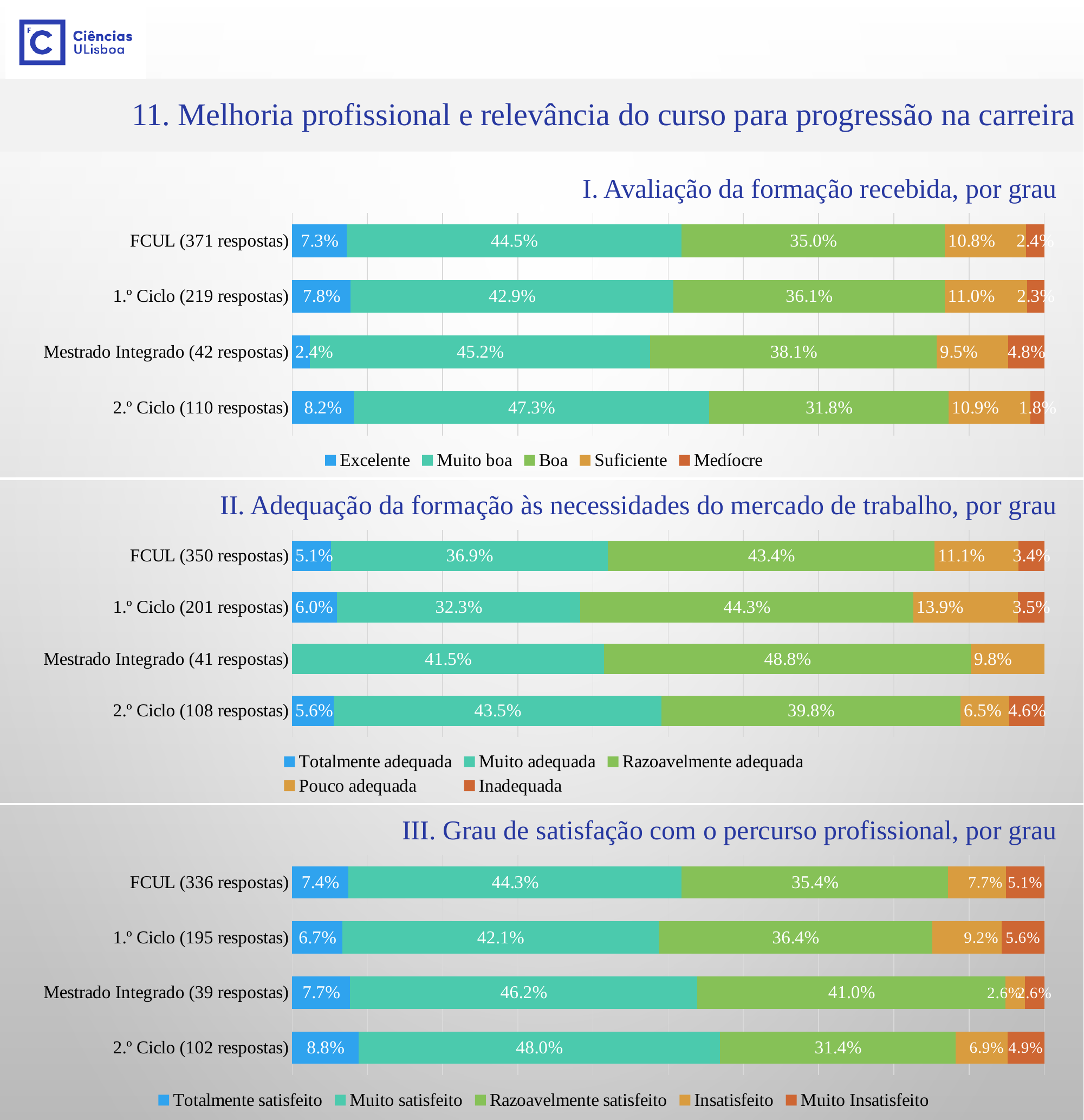
In chart III (Grau de satisfação com o percurso profissional, por grau), what is the difference between the 'Muito satisfeito' value for Mestrado Integrado (39 respostas) and for FCUL (336 respostas)? 1.9 percentage points In chart I (Avaliação da formação recebida, por grau), what is the difference between the 'Boa' value for FCUL (371 respostas) and for 2.º Ciclo (110 respostas)? 3.2 percentage points In chart III (Grau de satisfação com o percurso profissional, por grau), which category has the lowest 'Muito Insatisfeito' share? Mestrado Integrado (39 respostas) What kind of chart is chart III (Grau de satisfação com o percurso profissional, por grau)? Stacked bar chart In chart II (Adequação da formação às necessidades do mercado de trabalho, por grau), which has the larger 'Muito adequada' value: 1.º Ciclo (201 respostas) or 2.º Ciclo (108 respostas)? 2.º Ciclo (108 respostas) In chart III (Grau de satisfação com o percurso profissional, por grau), how many categories (bars) are shown? 4 In chart I (Avaliação da formação recebida, por grau), what is the 'Muito boa' value for 2.º Ciclo (110 respostas)? 47.3% In chart I (Avaliação da formação recebida, por grau), which category has the highest 'Excelente' share? 2.º Ciclo (110 respostas) In chart I (Avaliação da formação recebida, por grau), what is the 'Medíocre' value for Mestrado Integrado (42 respostas)? 4.8% In chart III (Grau de satisfação com o percurso profissional, por grau), what is the 'Totalmente satisfeito' value for 2.º Ciclo (102 respostas)? 8.8% In chart II (Adequação da formação às necessidades do mercado de trabalho, por grau), what is the 'Razoavelmente adequada' value for Mestrado Integrado (41 respostas)? 48.8% In chart II (Adequação da formação às necessidades do mercado de trabalho, por grau), how many series does the legend list? 5